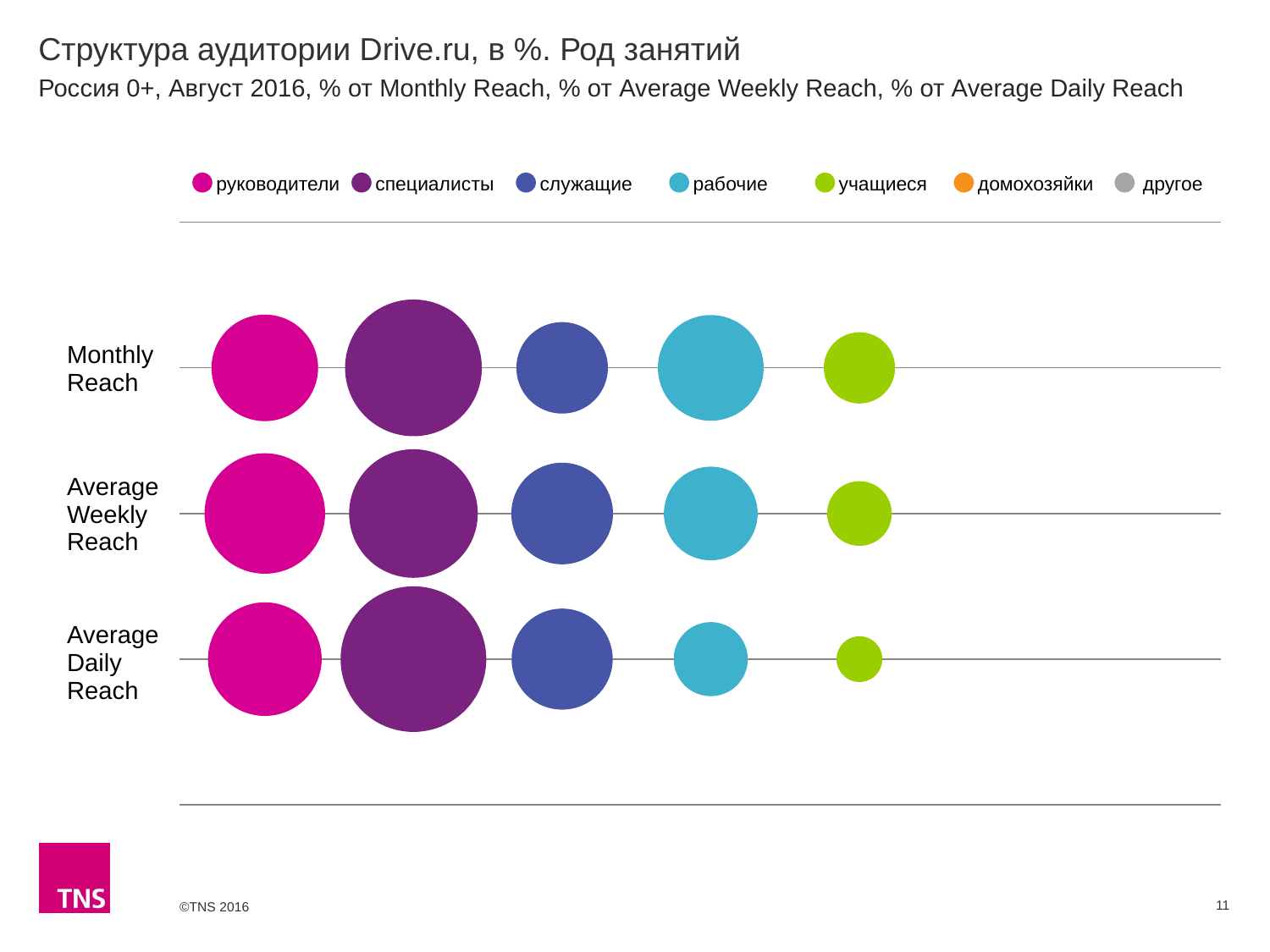
What is the title of the chart on the slide? Структура аудитории Drive.ru, в %. Род занятий How many series does the legend list? 7 Among the visible bubbles in the Average Daily Reach row, which occupation group has the smallest? учащиеся Which legend entry is shown in orange? домохозяйки Which occupation group has the largest bubble in the Monthly Reach row? специалисты How many reach categories (rows) are plotted on the chart? 3 What kind of chart is shown on the slide? Bubble chart Which occupation group has the largest bubble in the Average Daily Reach row? специалисты Does the специалисты bubble get larger or smaller going from Monthly Reach to Average Daily Reach? larger Does the учащиеся bubble get larger or smaller going from Monthly Reach to Average Daily Reach? smaller In the Average Weekly Reach row, which bubble is larger: специалисты or учащиеся? специалисты In the Average Daily Reach row, which bubble is larger: руководители or рабочие? руководители